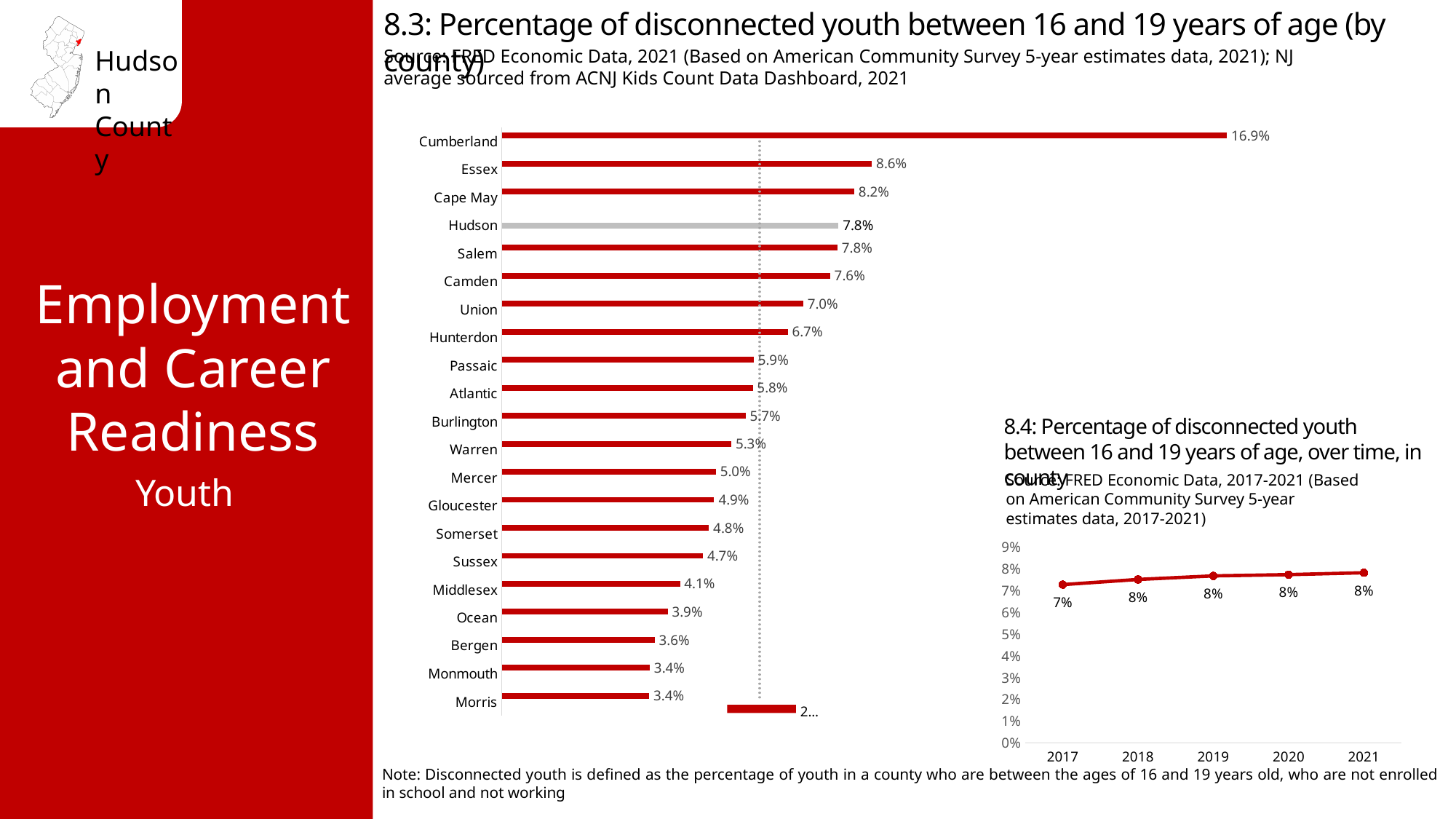
In the chart 8.3 (by county), what is the difference between Cumberland and Essex? 8.3% In the chart 8.3 (by county), which county has the highest percentage of disconnected youth? Cumberland What kind of chart is chart 8.4 (over time)? Line chart In the chart 8.3 (by county), what is the value for Middlesex? 4.1% In the chart 8.4 (over time), what is the value for 2021? 8% In the chart 8.4 (over time), what is the value for 2017? 7% In the chart 8.3 (by county), what is the value for Hudson? 7.8% What kind of chart is chart 8.3 (by county)? Bar chart In the chart 8.4 (over time), how many years are plotted? 5 In the chart 8.3 (by county), what is the difference between Union and Bergen? 3.4% In the chart 8.3 (by county), what is the value for Cumberland? 16.9% In the chart 8.3 (by county), which is larger, the value for Cape May or the value for Camden? Cape May